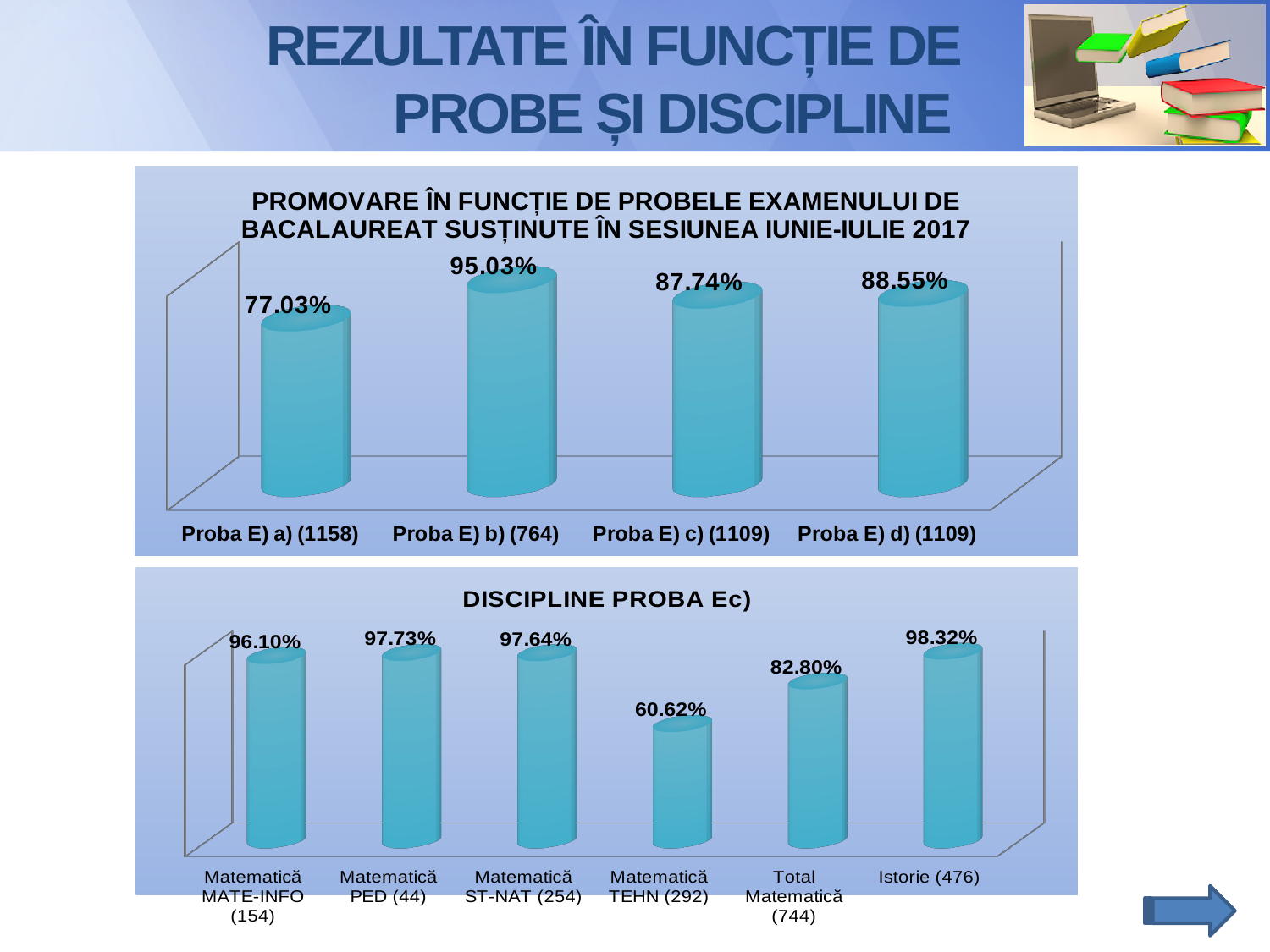
In the bottom chart, which is larger: the value for Matematică MATE-INFO (154) or Matematică PED (44)? Matematică PED (44) In the bottom chart (DISCIPLINE PROBA Ec), what is the value for Matematică TEHN (292)? 60.62% In the bottom chart, how many disciplines (categories) are shown? 6 In the top chart, which proba has the highest pass rate? Proba E) b) (764) In the top chart, how many probe (categories) are shown? 4 In the bottom chart, which discipline has the highest pass rate? Istorie (476) In the bottom chart, which discipline has the lowest pass rate? Matematică TEHN (292) In the top chart, which proba has the lowest pass rate? Proba E) a) (1158) In the top chart, what is the difference between the values for Proba E) b) (764) and Proba E) a) (1158)? 18.00% In the bottom chart, what is the value for Total Matematică (744)? 82.80% What type of chart is the top chart? Bar chart In the top chart (PROMOVARE ÎN FUNCȚIE DE PROBELE EXAMENULUI DE BACALAUREAT), what is the value for Proba E) a) (1158)? 77.03%